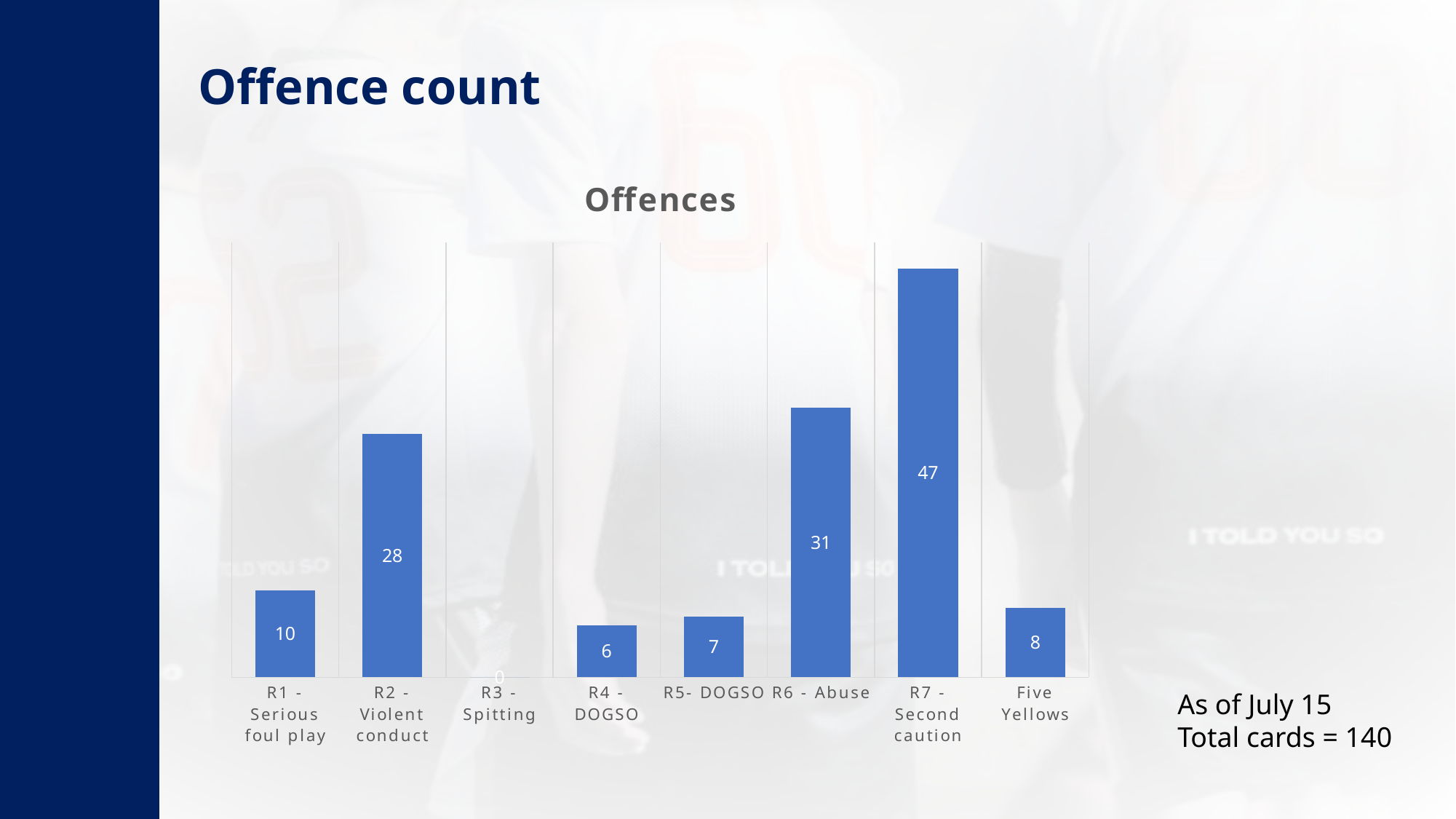
What is the title of the chart? Offences What is the difference between R7 - Second caution and R6 - Abuse? 16 How many categories are shown on the x axis? 8 What is the difference between R2 - Violent conduct and R1 - Serious foul play? 18 Which category has the highest value? R7 - Second caution What is the value for R2 - Violent conduct? 28 What kind of chart is this? Bar chart Which is larger, R5- DOGSO or R4 - DOGSO? R5- DOGSO What is the value for Five Yellows? 8 What is the value for R7 - Second caution? 47 Which category has the lowest value? R3 - Spitting What is the value for R4 - DOGSO? 6